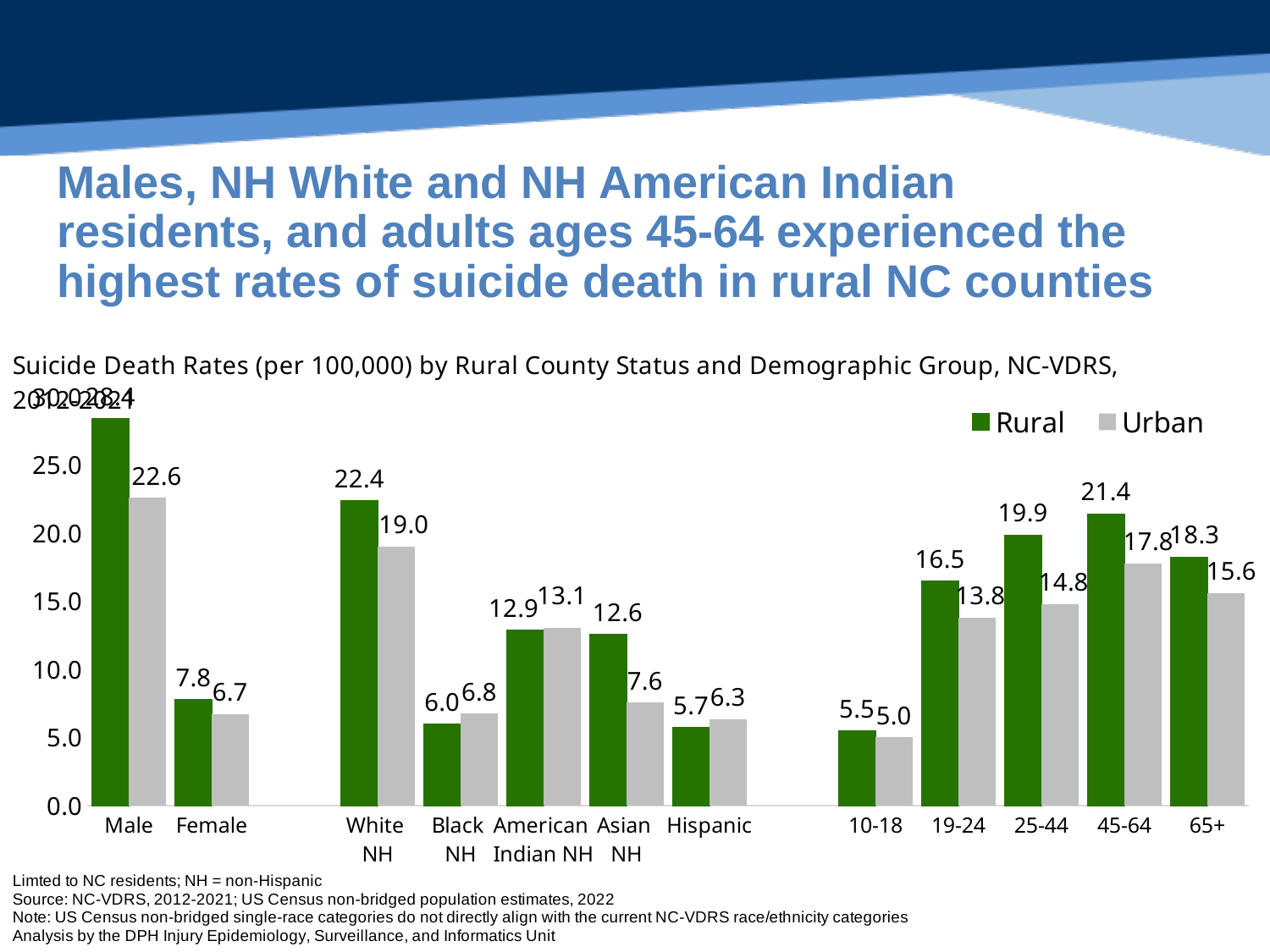
What is the Rural suicide death rate for Hispanic residents? 5.7 How many series does the legend list? 2 What is the difference between the Rural and Urban rates for Asian NH residents? 5.0 How many demographic categories are shown on the x axis? 12 Which age group has the highest Rural suicide death rate? 45-64 What type of chart is shown on the slide? bar chart Is the Rural suicide death rate for Male residents greater or less than 25.0? greater What is the Urban suicide death rate for the 45-64 age group? 17.8 Which category has the lowest Urban suicide death rate? 10-18 Is the Rural rate for Black NH residents higher or lower than the Urban rate for Black NH residents? lower What is the Urban suicide death rate for Male residents? 22.6 What is the Rural suicide death rate for White NH residents? 22.4